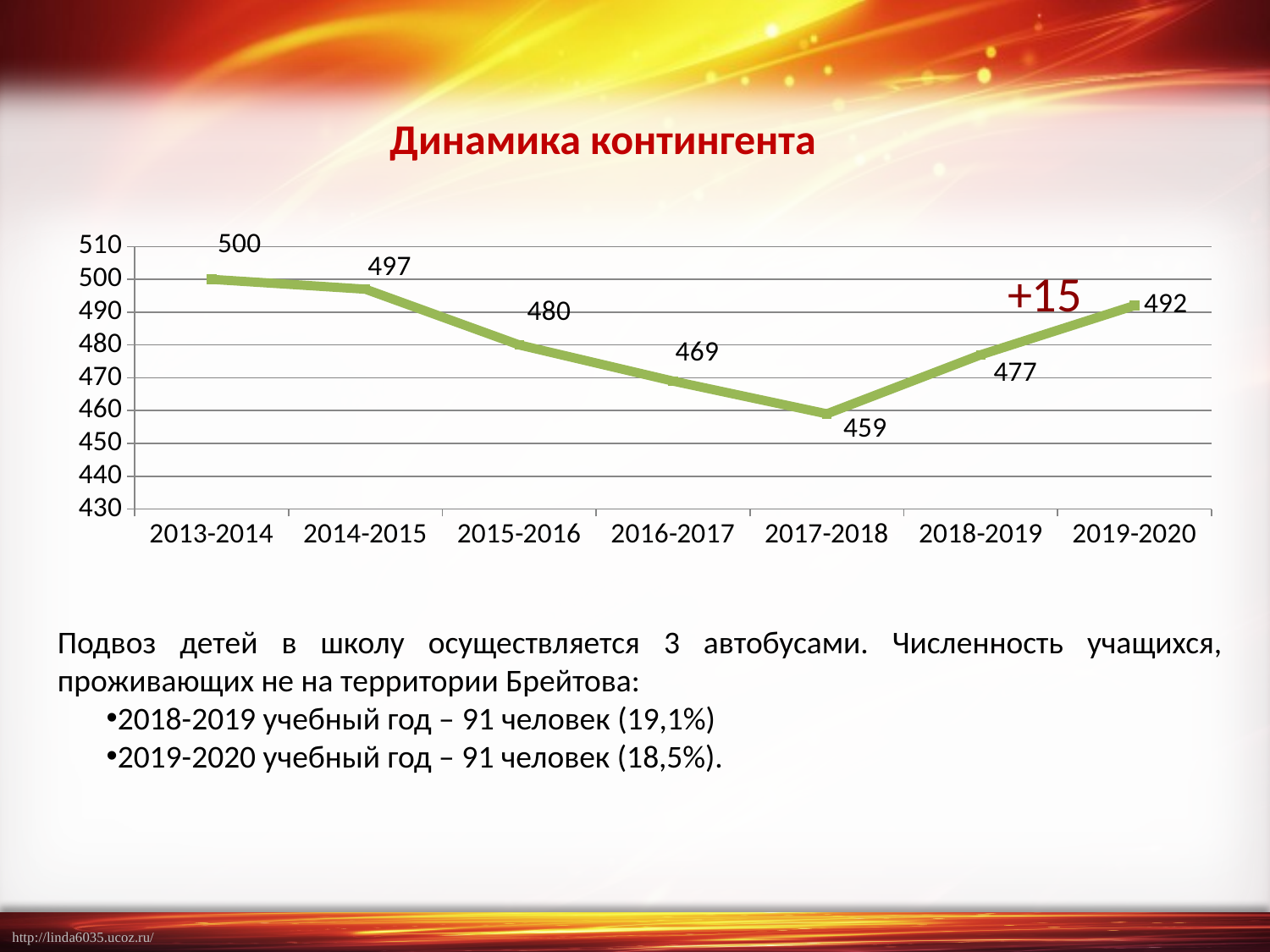
What is the value for 2013-2014? 500 What kind of chart is shown on the slide? line chart What is the difference between the values for 2019-2020 and 2018-2019? 15 What is the value for 2019-2020? 492 Which year has the highest value? 2013-2014 Which year has the lowest value? 2017-2018 What is the difference between the values for 2013-2014 and 2017-2018? 41 Do the values rise or fall from 2013-2014 to 2017-2018? fall Which is larger, the value for 2015-2016 or the value for 2016-2017? 2015-2016 How many years are plotted on the chart? 7 Is the value for 2018-2019 greater or less than 470? greater What is the value for 2017-2018? 459